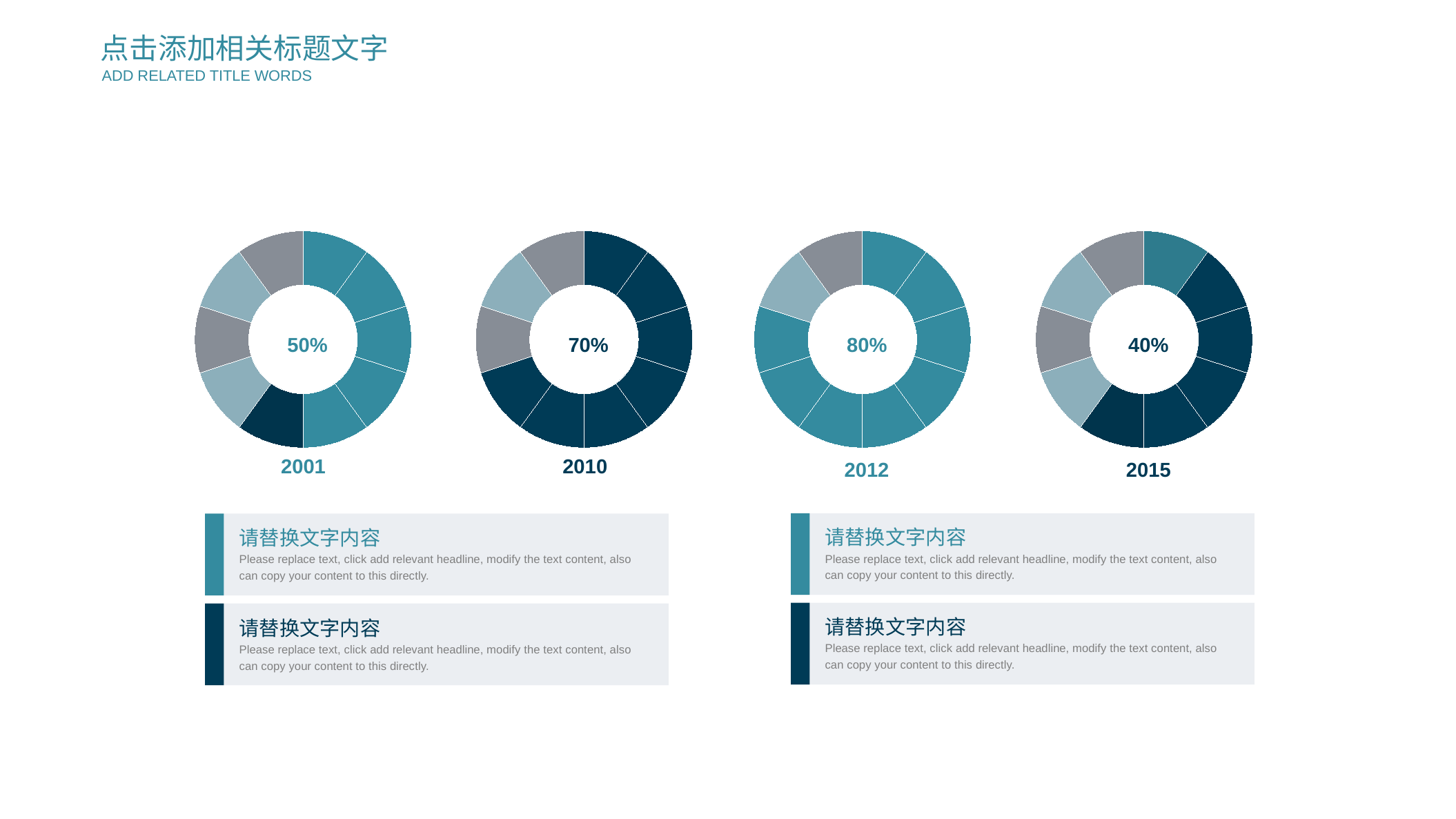
Which year's donut chart shows the highest percentage? 2012 What is the difference between the percentage shown for 2012 and the percentage shown for 2001? 30% What percentage is shown in the centre of the 2010 donut chart? 70% What kind of chart is used for each of the four years on the slide? Donut chart Into how many segments is the 2001 donut chart divided? 10 What is the difference between the percentage shown for 2010 and the percentage shown for 2015? 30% What percentage is shown in the centre of the 2012 donut chart? 80% Which year's donut chart shows the lowest percentage? 2015 What percentage is shown in the centre of the 2015 donut chart? 40% How many donut charts are on the slide? 4 What percentage is shown in the centre of the 2001 donut chart? 50% Which is larger, the percentage shown for 2010 or the percentage shown for 2015? 2010